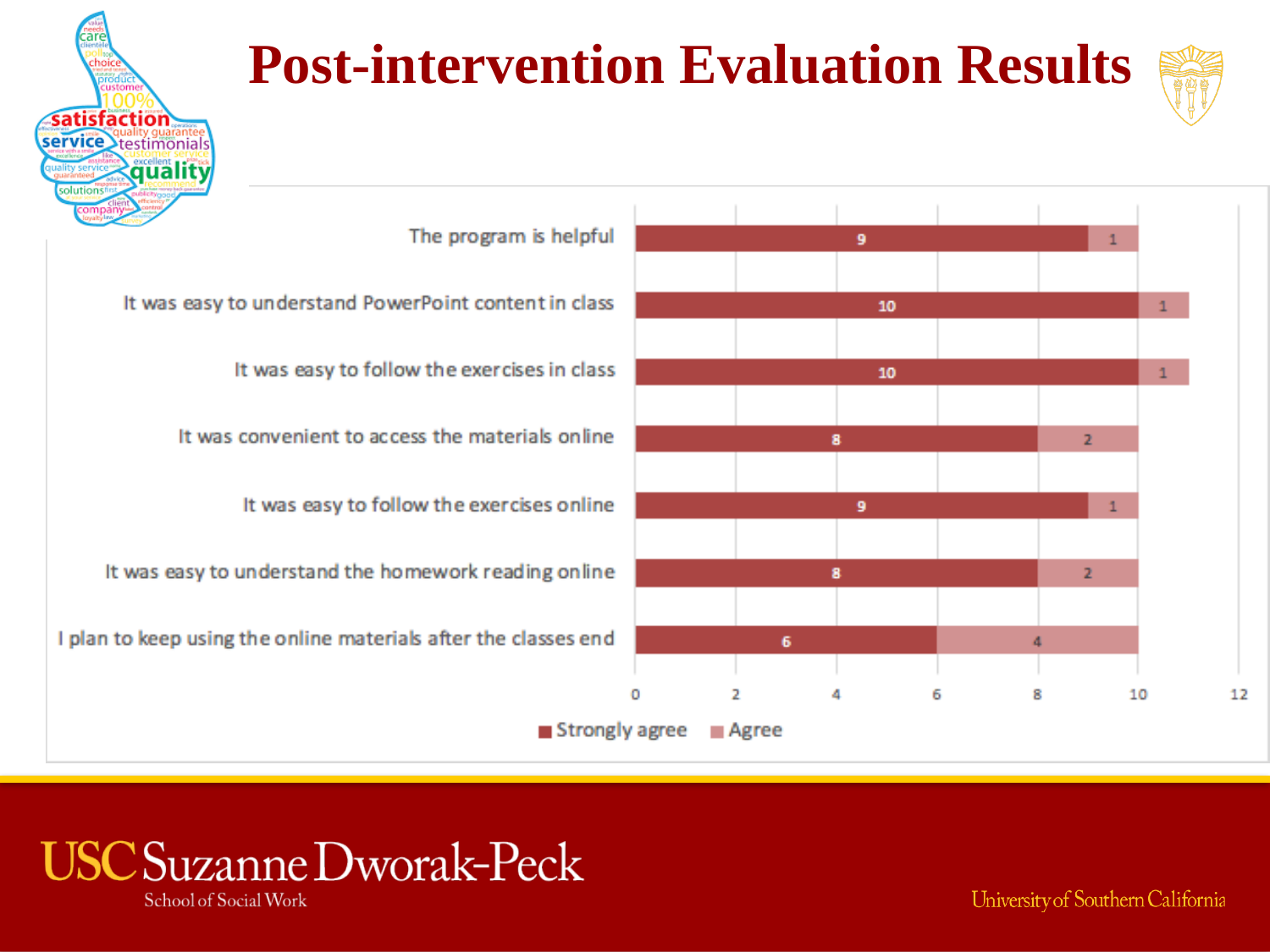
How many series does the legend list? 2 What is the 'Strongly agree' value for 'The program is helpful'? 9 What is the 'Strongly agree' value for 'It was convenient to access the materials online'? 8 What kind of chart is shown on the slide? Stacked bar chart What is the difference between the 'Strongly agree' values for 'It was easy to follow the exercises in class' and 'I plan to keep using the online materials after the classes end'? 4 Which category has the highest 'Agree' value? I plan to keep using the online materials after the classes end Which category has the lowest 'Strongly agree' value? I plan to keep using the online materials after the classes end Which is larger: the 'Strongly agree' value for 'It was easy to follow the exercises online' or for 'It was easy to understand the homework reading online'? It was easy to follow the exercises online What is the total of the stacked bar for 'It was easy to understand PowerPoint content in class'? 11 What is the 'Agree' value for 'I plan to keep using the online materials after the classes end'? 4 What is the total of the stacked bar for 'It was convenient to access the materials online'? 10 How many categories are shown on the chart? 7